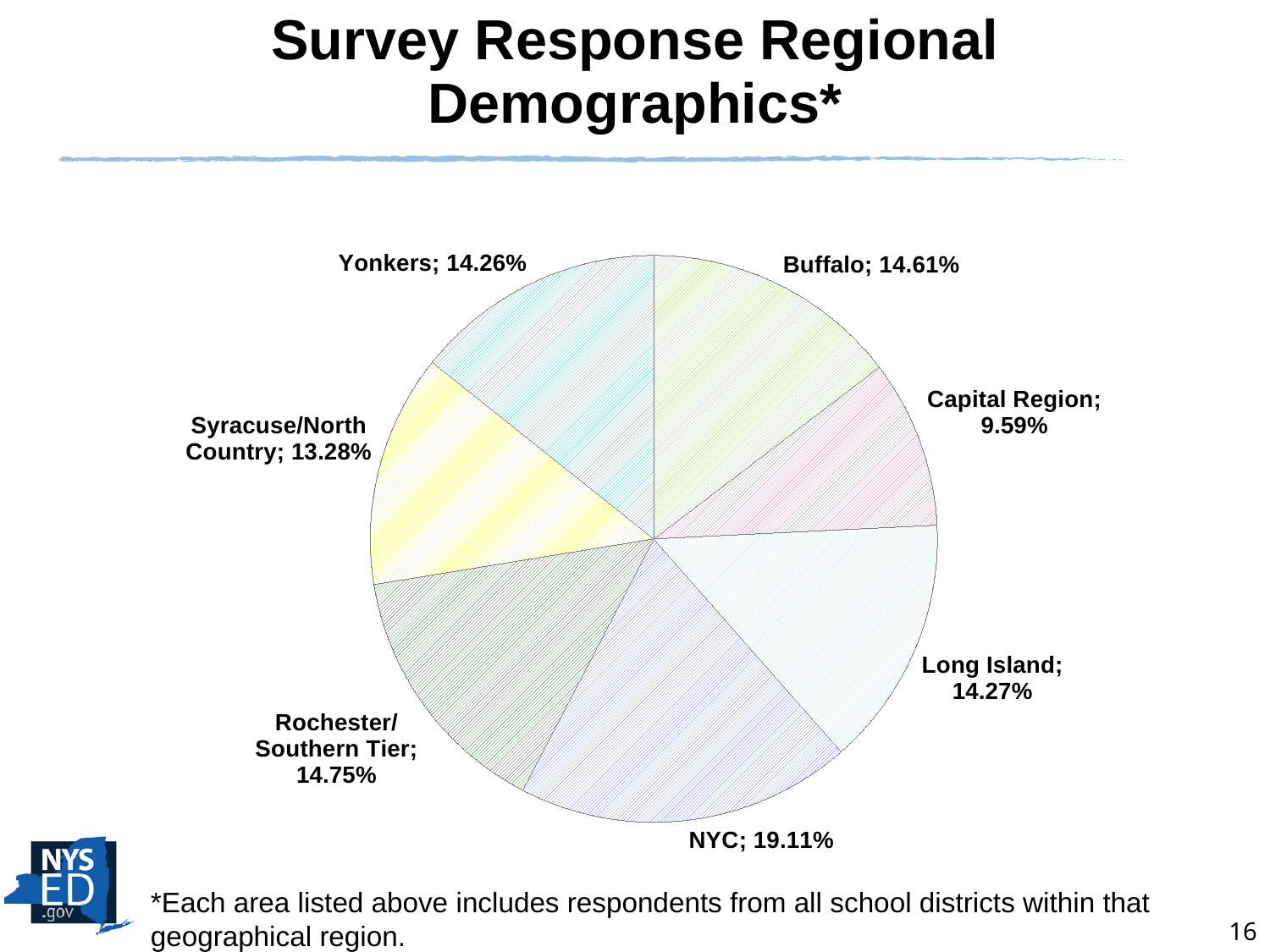
What is the value shown for Rochester/Southern Tier? 14.75% What is the difference between the Long Island share and the Syracuse/North Country share? 0.99% What is the difference between the NYC share and the Capital Region share? 9.52% What percentage of survey responses came from the Capital Region? 9.59% What is the title of the chart on the slide? Survey Response Regional Demographics* Which region has the largest share of survey responses? NYC How many regions are shown in the pie chart? 7 Which is larger, the share for Buffalo or the share for Yonkers? Buffalo What is the value shown for Syracuse/North Country? 13.28% Which region has the smallest share of survey responses? Capital Region What percentage of survey responses came from NYC? 19.11% What kind of chart is shown on the slide? Pie chart